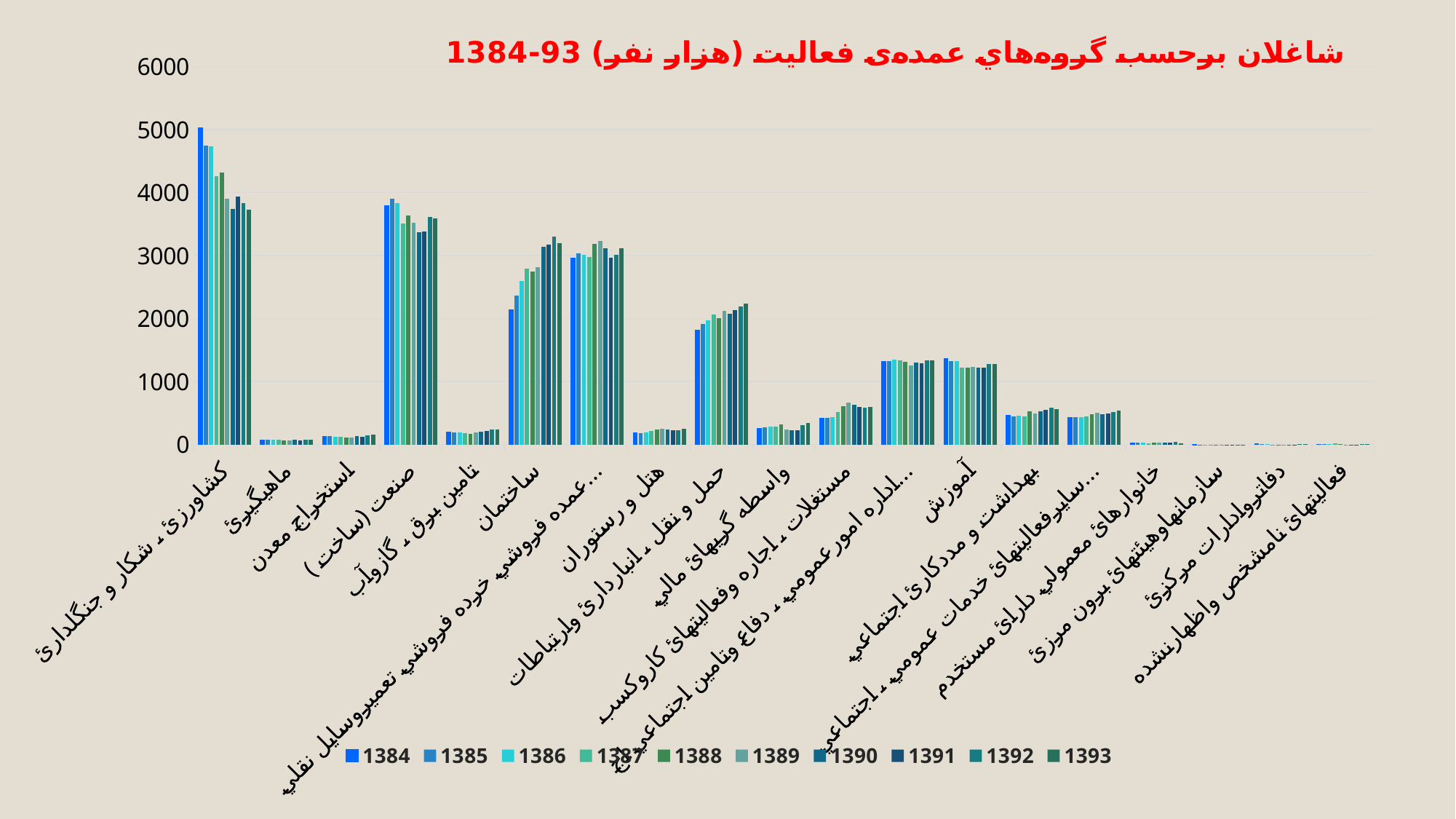
For ساختمان, which is larger: the 1384 value or the 1393 value? 1393 Is the value for کشاورزی، شکار و جنگلداری in 1384 greater or less than 4000? greater What kind of chart is shown on the slide? bar chart Is the value for صنعت (ساخت) in 1385 greater or less than 3000? greater How many series does the legend list? 10 Is the value for کشاورزی، شکار و جنگلداری in 1393 greater or less than 4000? less How many activity-group categories are shown on the x axis? 19 Do the values for حمل و نقل، انبارداری و ارتباطات generally rise or fall from 1384 to 1393? rise Which activity group has the tallest bar on the chart? کشاورزی، شکار و جنگلداری For کشاورزی، شکار و جنگلداری, which is larger: the 1384 value or the 1393 value? 1384